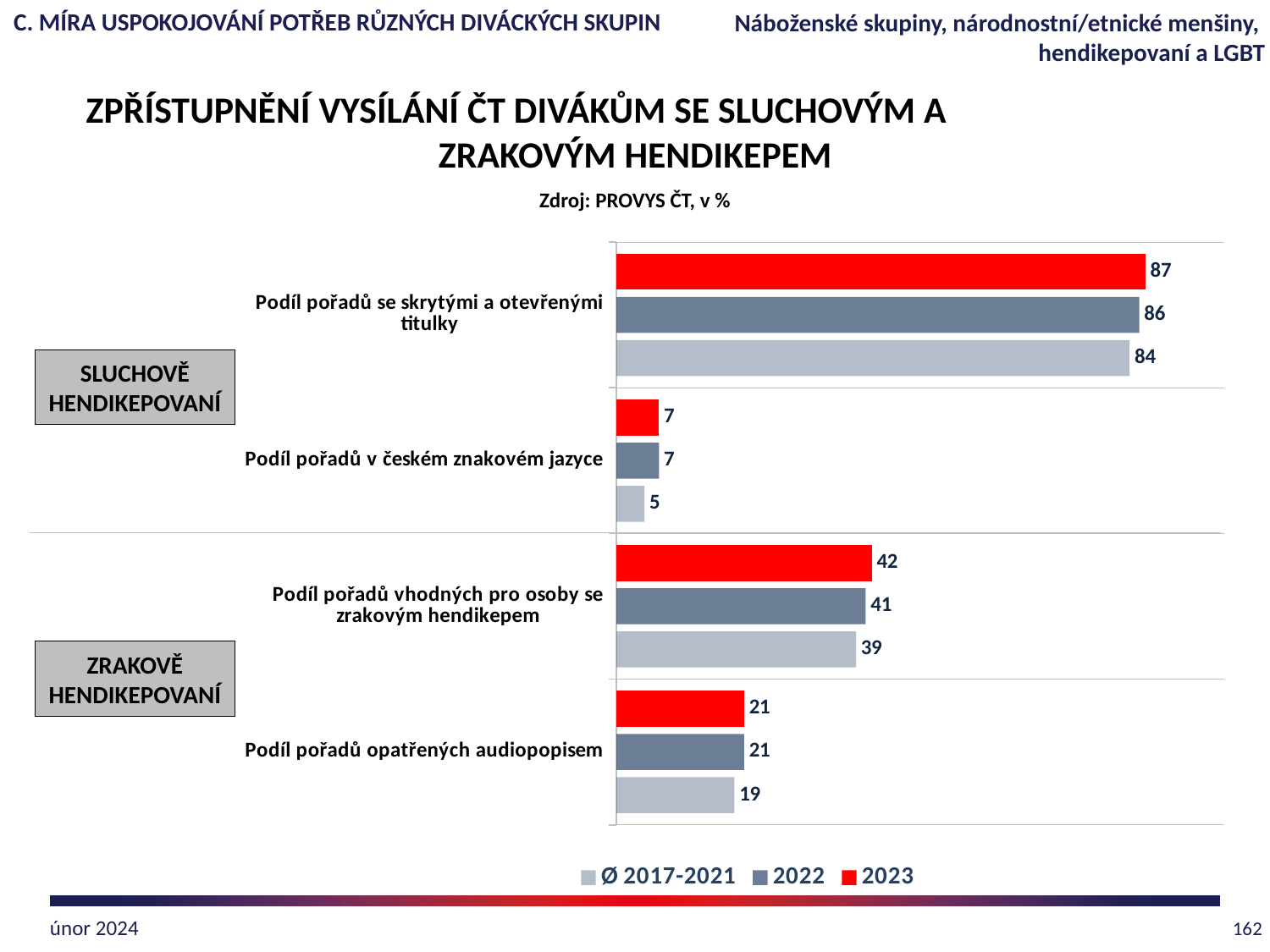
What is the difference between the 2023 and Ø 2017-2021 values for 'Podíl pořadů se skrytými a otevřenými titulky'? 3 What is the difference between the 2023 and Ø 2017-2021 values for 'Podíl pořadů vhodných pro osoby se zrakovým hendikepem'? 3 How many categories are shown in the chart? 4 Which category has the highest 2023 value? Podíl pořadů se skrytými a otevřenými titulky Which is larger: the 2023 value for 'Podíl pořadů opatřených audiopopisem' or the 2023 value for 'Podíl pořadů v českém znakovém jazyce'? Podíl pořadů opatřených audiopopisem What is the 2023 value for 'Podíl pořadů se skrytými a otevřenými titulky'? 87 What is the Ø 2017-2021 value for 'Podíl pořadů v českém znakovém jazyce'? 5 What is the 2022 value for 'Podíl pořadů vhodných pro osoby se zrakovým hendikepem'? 41 How many series does the legend list? 3 Which category has the lowest 2022 value? Podíl pořadů v českém znakovém jazyce What kind of chart is shown on the slide? Bar chart What is the Ø 2017-2021 value for 'Podíl pořadů opatřených audiopopisem'? 19